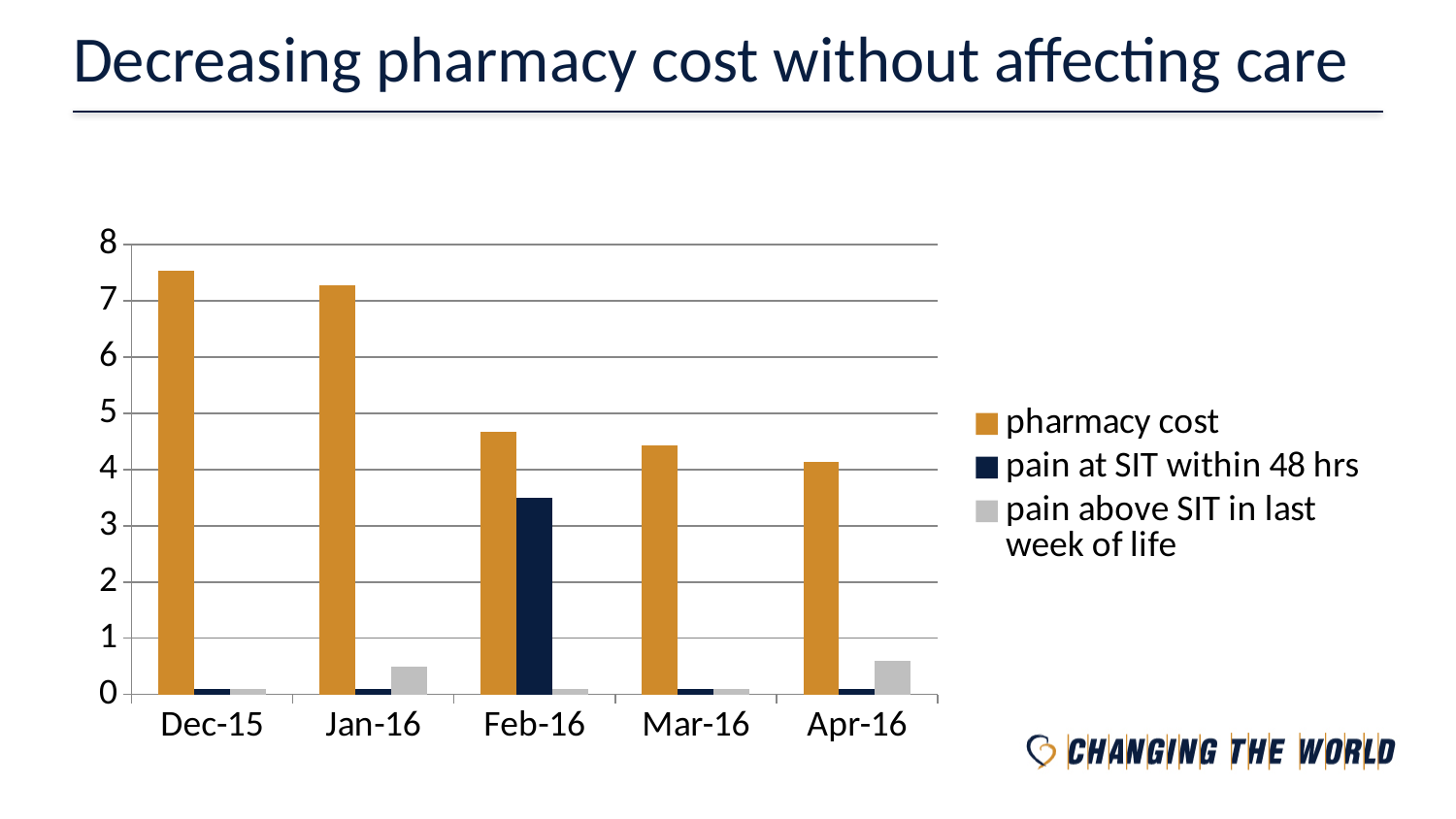
What is the title of the slide? Decreasing pharmacy cost without affecting care How many series does the legend list? 3 Which is larger, the pharmacy cost for Jan-16 or for Feb-16? Jan-16 Is the pharmacy cost for Apr-16 greater or less than 5? less How many months are shown on the x axis? 5 What kind of chart is shown on the slide? bar chart Is the pharmacy cost for Dec-15 greater or less than 7? greater Which month has the highest pharmacy cost? Dec-15 Which month has the lowest pharmacy cost? Apr-16 Which month has the highest value for pain at SIT within 48 hrs? Feb-16 Does the pharmacy cost rise or fall from Dec-15 to Apr-16? fall Is the value for pain at SIT within 48 hrs in Feb-16 greater or less than 3? greater